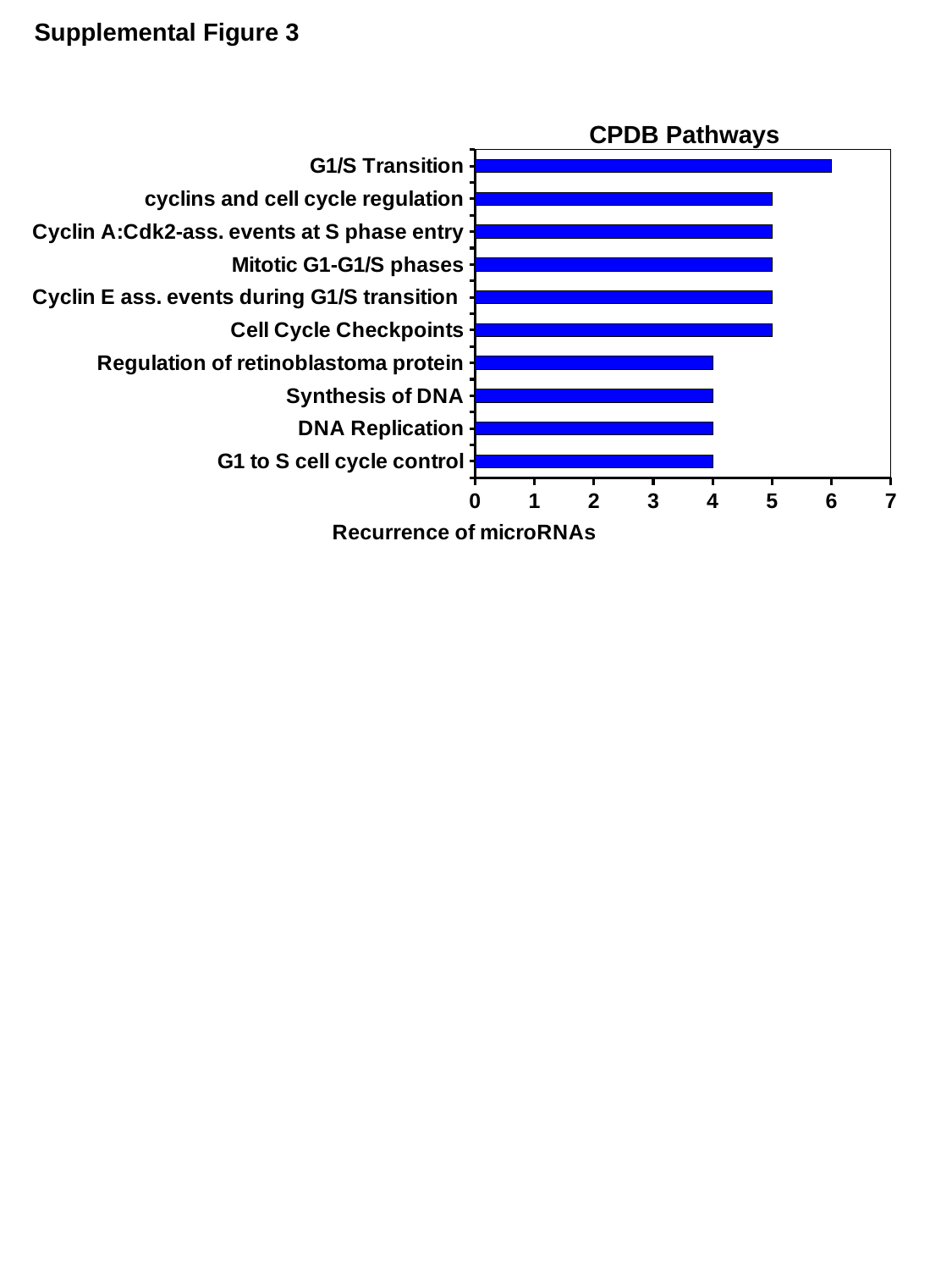
What is the label of the x axis? Recurrence of microRNAs What is the recurrence of microRNAs for DNA Replication? 4 What is the title of the chart? CPDB Pathways What is the difference in recurrence of microRNAs between G1/S Transition and Synthesis of DNA? 2 What is the recurrence of microRNAs for Cell Cycle Checkpoints? 5 Which has a larger recurrence of microRNAs, Mitotic G1-G1/S phases or G1 to S cell cycle control? Mitotic G1-G1/S phases What is the recurrence of microRNAs for G1/S Transition? 6 Which pathway has the highest recurrence of microRNAs? G1/S Transition What kind of chart is shown on the slide? bar chart How many pathways are plotted in the chart? 10 What is the recurrence of microRNAs for cyclins and cell cycle regulation? 5 Is the value for Regulation of retinoblastoma protein greater or less than 5? less